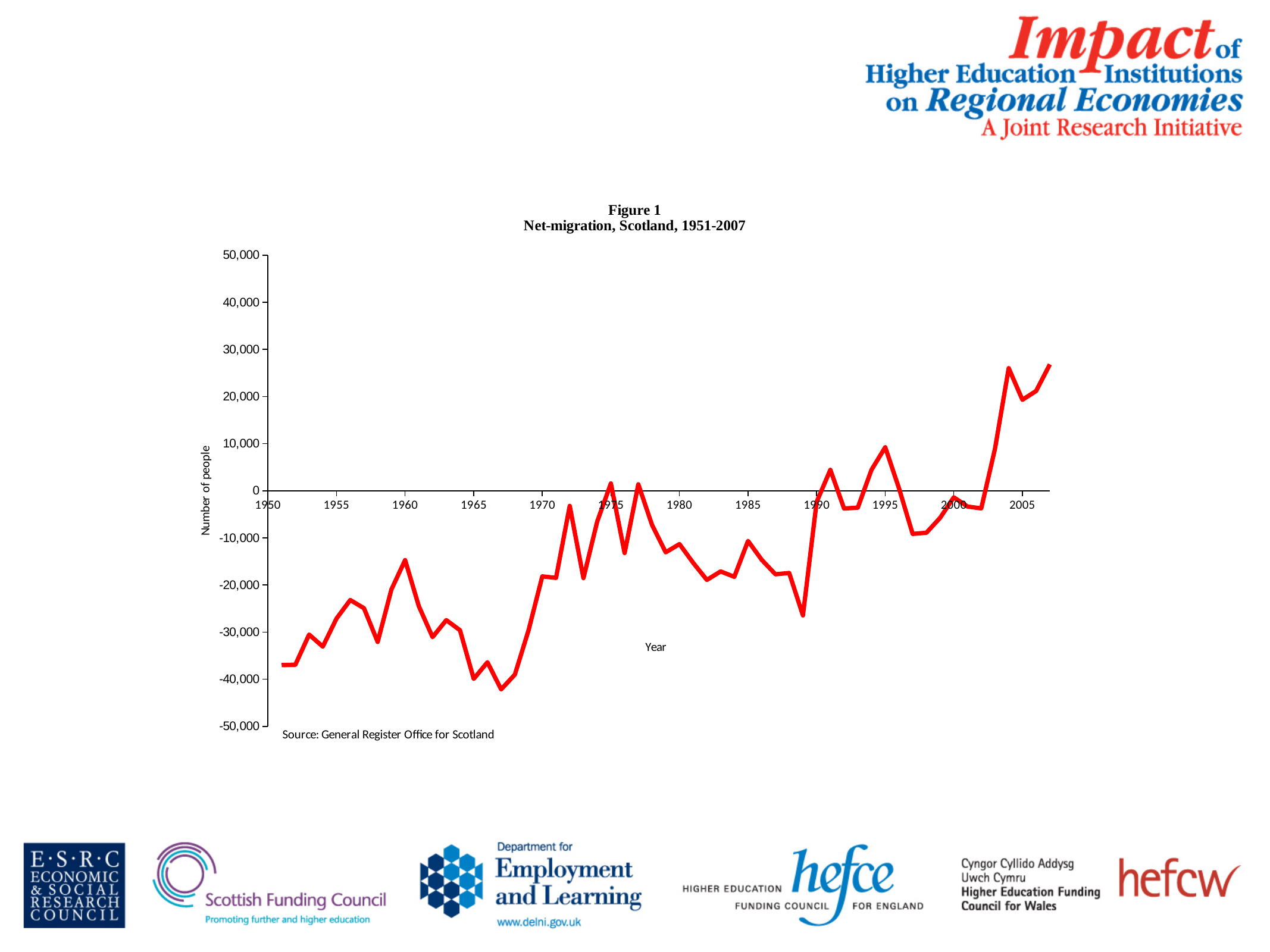
What is the title of the chart? Net-migration, Scotland, 1951-2007 Is the net-migration value for 1960 greater or less than -20,000? greater Which year has the larger net-migration value, 1960 or 1967? 1960 Is the net-migration value for 1951 greater or less than -30,000? less Is the net-migration value for 2007 greater or less than 20,000? greater Overall, do net-migration values rise or fall from 1951 to 2007? rise What kind of chart is shown on the slide? line chart What is the label on the vertical axis of the chart? Number of people Which year has the larger net-migration value, 1951 or 2004? 2004